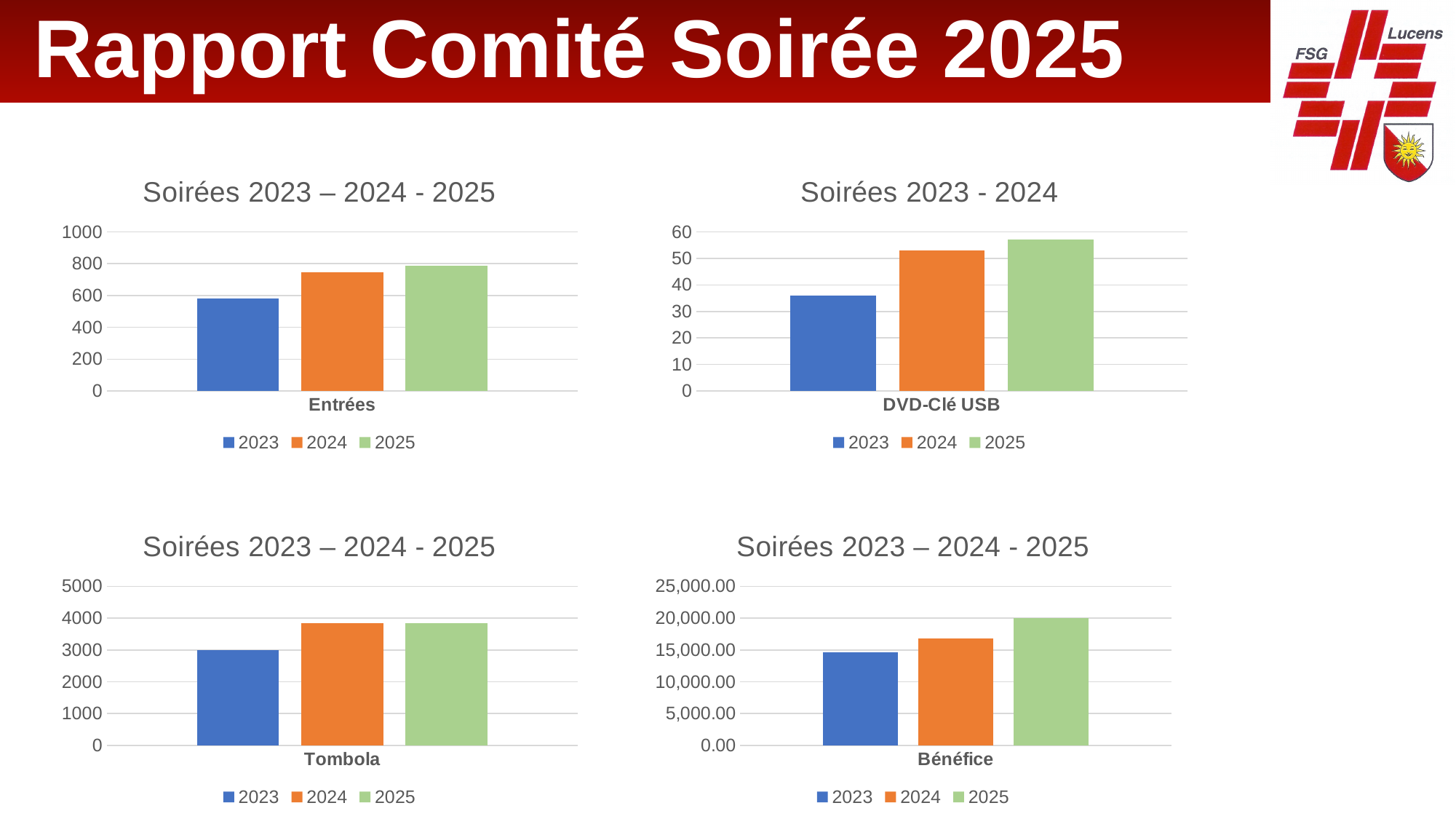
What kind of chart is the bottom-left chart (Tombola)? Bar chart In the bottom-right chart (Bénéfice), which year has the highest bar? 2025 In the bottom-left chart (Tombola), which year has the lowest bar? 2023 In the bottom-right chart (Bénéfice), which is larger, the value for 2023 or the value for 2025? 2025 In the top-right chart (DVD-Clé USB), is the value for 2025 greater or less than 60? less In the bottom-right chart (Bénéfice), is the value for 2024 greater or less than 15,000.00? greater In the top-right chart (DVD-Clé USB), is the value for 2023 greater or less than 30? greater How many series does the legend of the top-left chart (Entrées) list? 3 In the top-left chart (Entrées), which year has the lowest bar? 2023 In the top-right chart (DVD-Clé USB), which year has the highest bar? 2025